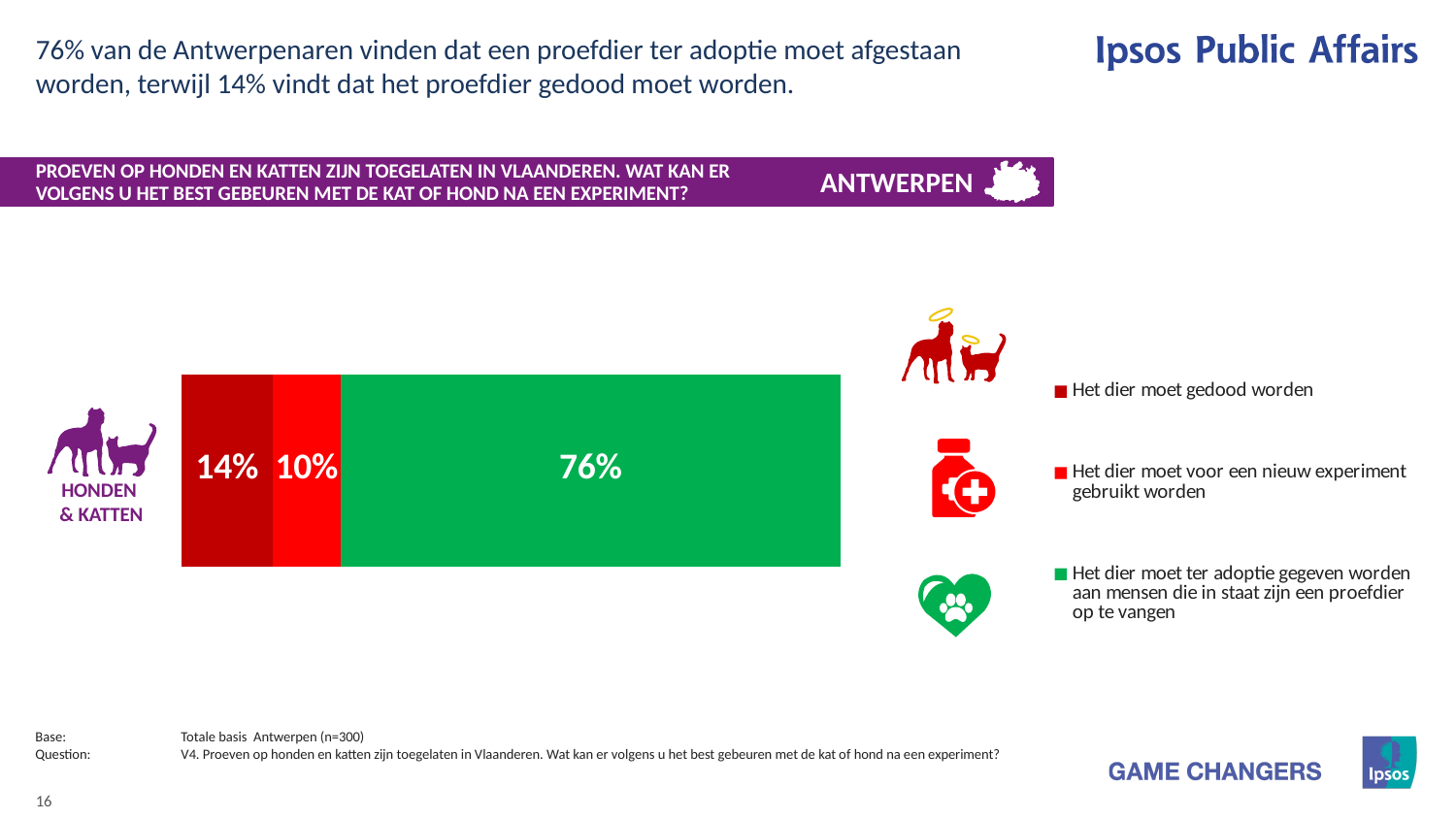
What percentage of respondents say the animal should be put up for adoption ("Het dier moet ter adoptie gegeven worden")? 76% What colour is the segment representing "Het dier moet ter adoptie gegeven worden"? Green What percentage of respondents say the animal should be killed ("Het dier moet gedood worden")? 14% Which response option has the largest share in the bar? Het dier moet ter adoptie gegeven worden aan mensen die in staat zijn een proefdier op te vangen How many series does the legend list? 3 Which response option has the smallest share in the bar? Het dier moet voor een nieuw experiment gebruikt worden What is the total of the three segments in the stacked bar? 100% Which is larger: the share for "Het dier moet gedood worden" or the share for "Het dier moet voor een nieuw experiment gebruikt worden"? Het dier moet gedood worden What is the difference in percentage points between the share for killing the animal (14%) and the share for using it in a new experiment (10%)? 4 What percentage of respondents say the animal should be used for a new experiment ("Het dier moet voor een nieuw experiment gebruikt worden")? 10% What is the difference in percentage points between the share for adoption (76%) and the share for killing the animal (14%)? 62 What kind of chart is shown on the slide? Stacked bar chart